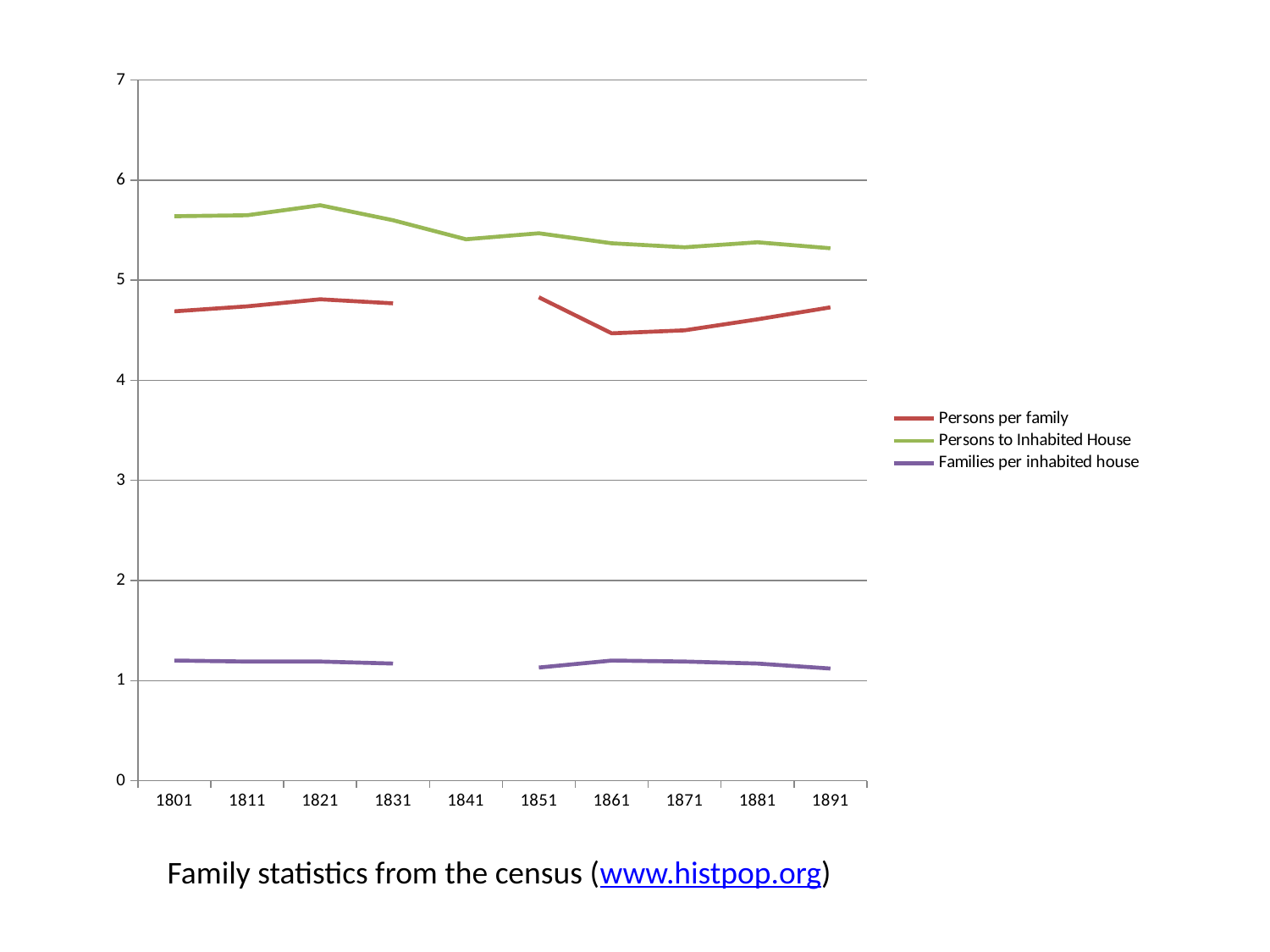
Is the value for Families per inhabited house in 1801 greater or less than 1? greater Is the value for Persons to Inhabited House in 1891 greater or less than 6? less Is the value for Persons per family in 1861 greater or less than 5? less What kind of chart is shown on the slide? line chart Which is larger in 1801: Persons per family or Persons to Inhabited House? Persons to Inhabited House Does the Persons to Inhabited House series generally rise or fall from 1801 to 1891? fall For Persons per family, which year has the larger value: 1821 or 1861? 1821 How many series does the legend list? 3 Which series is drawn in red? Persons per family In which year is the Persons to Inhabited House series at its highest? 1821 How many census years are shown on the x axis? 10